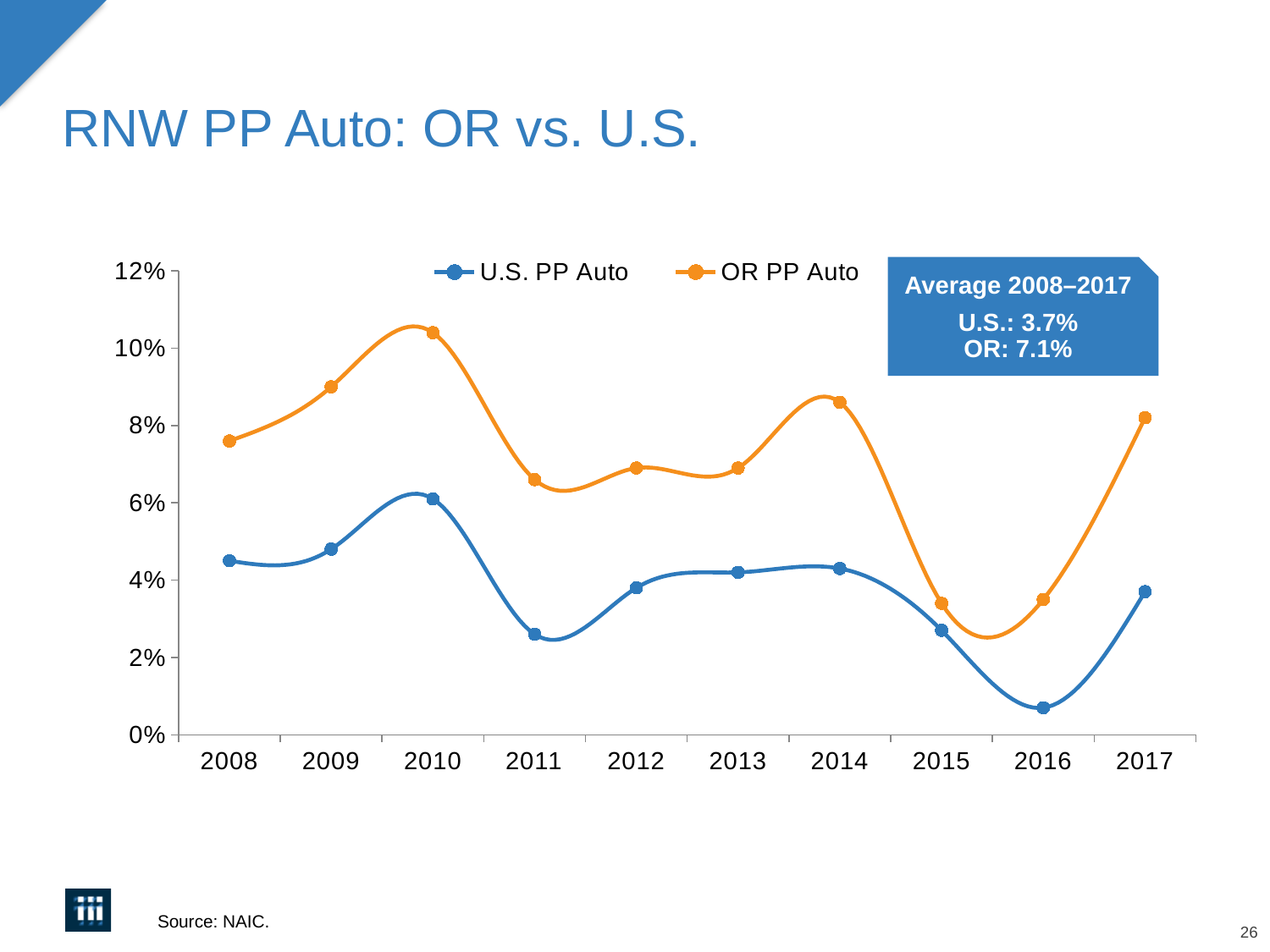
In which year does the OR PP Auto series reach its highest value? 2010 Is the value for OR PP Auto in 2010 greater or less than 8%? greater Does the U.S. PP Auto series rise or fall from 2014 to 2016? fall Which series has the larger value in 2017, U.S. PP Auto or OR PP Auto? OR PP Auto Is the value for U.S. PP Auto in 2016 greater or less than 2%? less In which year does the U.S. PP Auto series reach its lowest value? 2016 Is the value for OR PP Auto in 2015 greater or less than 6%? less In which year does the U.S. PP Auto series reach its highest value? 2010 What kind of chart is shown on the slide? line chart How many years are plotted along the x axis? 10 How many series does the legend list? 2 According to the callout box, what is the OR average for 2008–2017? 7.1%